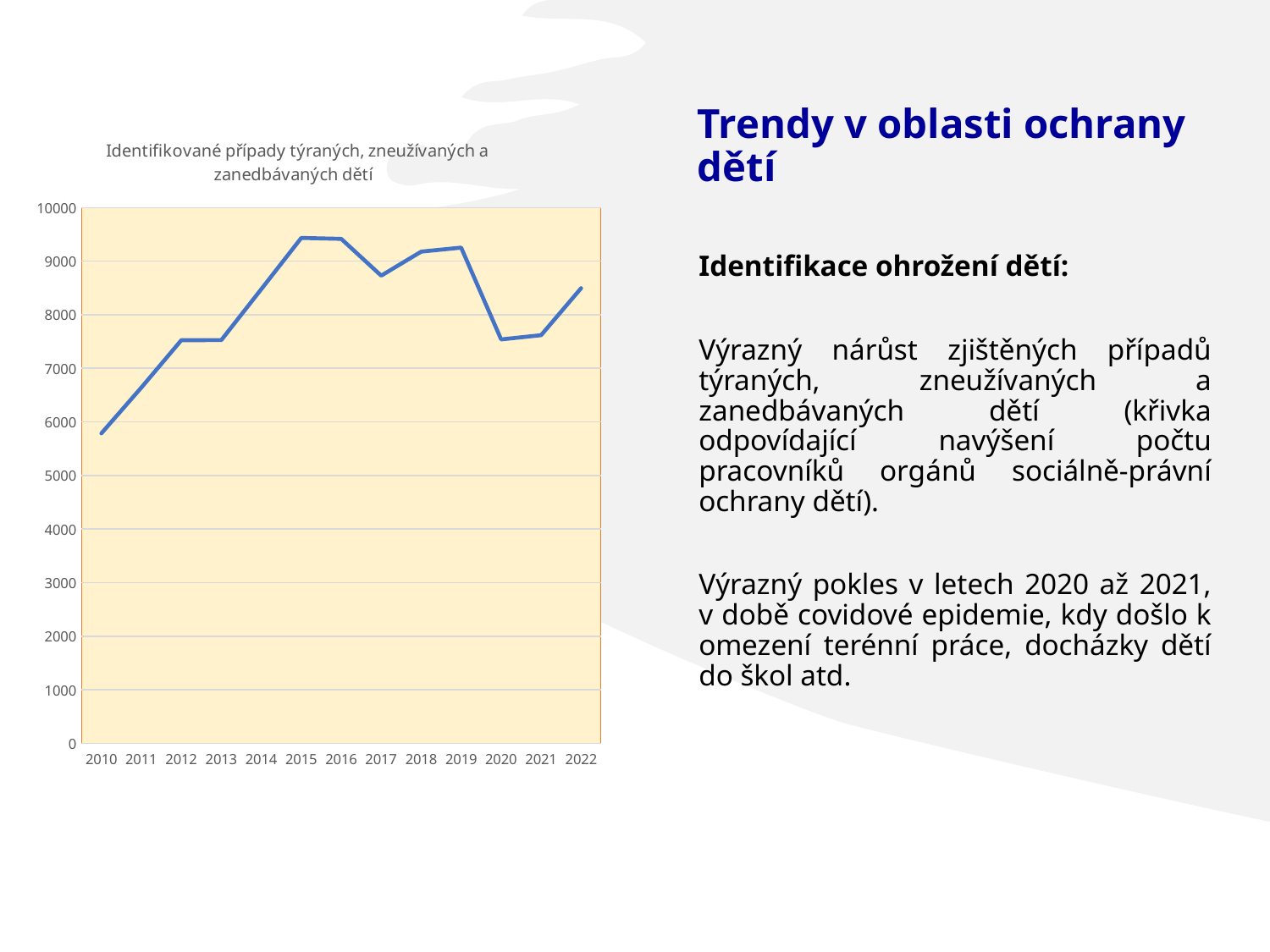
Do the values rise or fall from 2010 to 2015? rise What is the title of the chart? Identifikované případy týraných, zneužívaných a zanedbávaných dětí Is the value for 2015 greater or less than 9000? greater What kind of chart is shown on the slide? line chart Is the value for 2017 greater or less than 9000? less How many years are plotted along the x axis of the chart? 13 Is the value for 2020 greater or less than 8000? less Which year has the larger value, 2019 or 2020? 2019 Which year has the lowest value in the chart? 2010 Which year has the larger value, 2010 or 2022? 2022